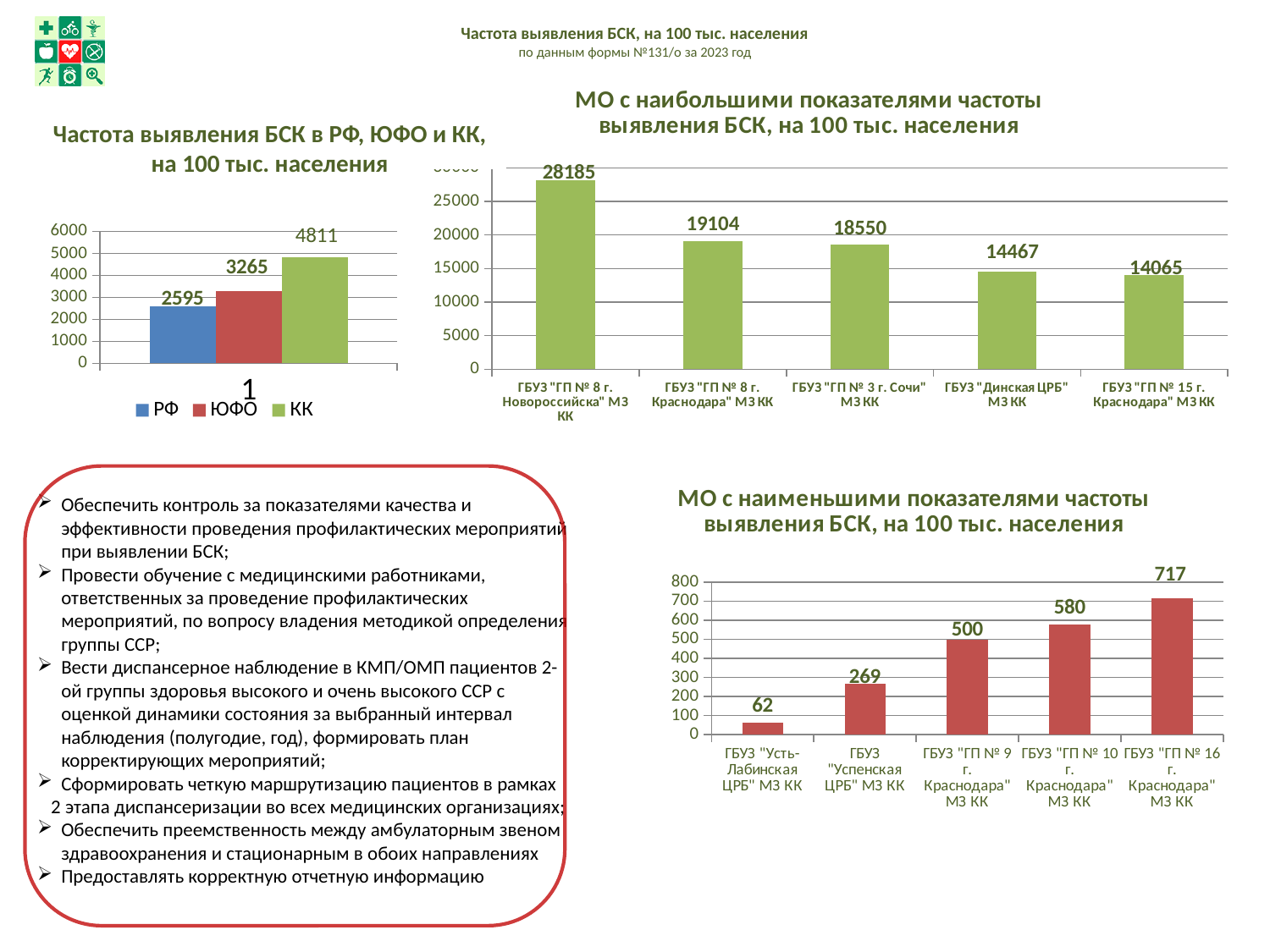
In the chart 'МО с наименьшими показателями частоты выявления БСК, на 100 тыс. населения', do the values rise or fall from left to right? rise In the chart 'Частота выявления БСК в РФ, ЮФО и КК, на 100 тыс. населения', which series has the lowest value? РФ In the chart 'МО с наибольшими показателями частоты выявления БСК, на 100 тыс. населения', which organisation has the highest value? ГБУЗ "ГП № 8 г. Новороссийска" МЗ КК In the chart 'Частота выявления БСК в РФ, ЮФО и КК, на 100 тыс. населения', what is the value for КК? 4811 In the chart 'МО с наименьшими показателями частоты выявления БСК, на 100 тыс. населения', which organisation has the lowest value? ГБУЗ "Усть-Лабинская ЦРБ" МЗ КК In the chart 'Частота выявления БСК в РФ, ЮФО и КК, на 100 тыс. населения', what is the difference between the values for ЮФО and РФ? 670 In the chart 'МО с наибольшими показателями частоты выявления БСК, на 100 тыс. населения', what is the difference between the values for ГБУЗ "ГП № 8 г. Новороссийска" МЗ КК and ГБУЗ "ГП № 8 г. Краснодара" МЗ КК? 9081 In the chart 'МО с наименьшими показателями частоты выявления БСК, на 100 тыс. населения', what is the value for ГБУЗ "Успенская ЦРБ" МЗ КК? 269 What kind of chart is 'МО с наименьшими показателями частоты выявления БСК, на 100 тыс. населения'? bar chart In the chart 'МО с наибольшими показателями частоты выявления БСК, на 100 тыс. населения', what is the value for ГБУЗ "ГП № 3 г. Сочи" МЗ КК? 18550 In the chart 'МО с наибольшими показателями частоты выявления БСК, на 100 тыс. населения', how many organisations are shown? 5 In the chart 'Частота выявления БСК в РФ, ЮФО и КК, на 100 тыс. населения', how many series does the legend list? 3